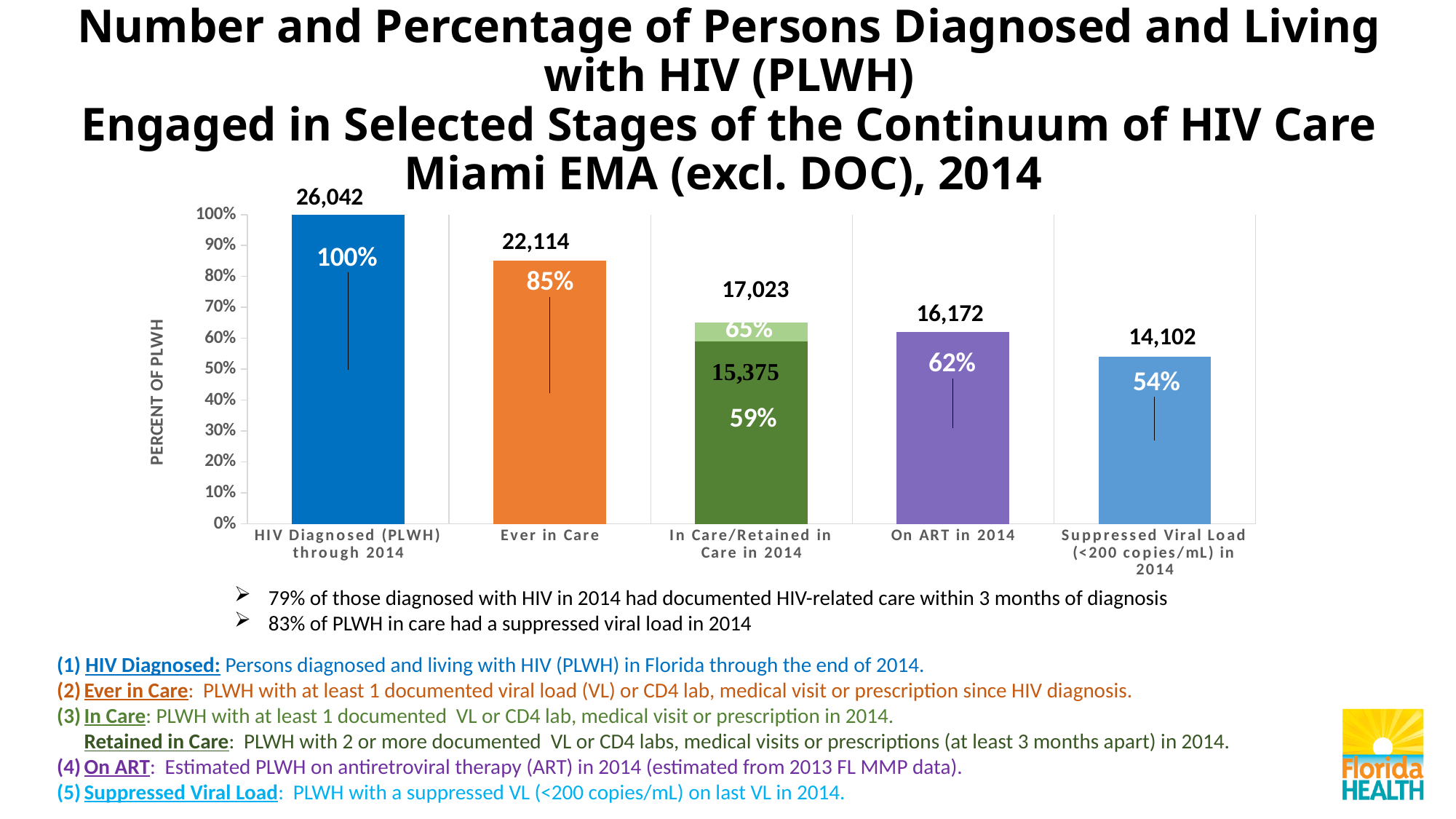
Which category has the lowest percentage of PLWH? Suppressed Viral Load (<200 copies/mL) in 2014 What is the label of the y axis of the chart? PERCENT OF PLWH What percentage of PLWH is shown for 'On ART in 2014'? 62% What is the difference in the number of persons between 'HIV Diagnosed (PLWH) through 2014' and 'Ever in Care'? 3,928 What is the number of persons shown for 'Suppressed Viral Load (<200 copies/mL) in 2014'? 14,102 Which is larger: the number of persons 'On ART in 2014' or the number with 'Suppressed Viral Load (<200 copies/mL) in 2014'? On ART in 2014 Do the percentages generally rise or fall moving from left to right across the stages of care? fall What type of chart is shown on the slide? bar chart Which category has the highest number of persons? HIV Diagnosed (PLWH) through 2014 What is the number of persons shown for 'Ever in Care'? 22,114 How many categories (stages of care) are shown on the x axis of the chart? 5 What percentage is shown for the retained-in-care (dark green) portion of the 'In Care/Retained in Care in 2014' bar? 59%